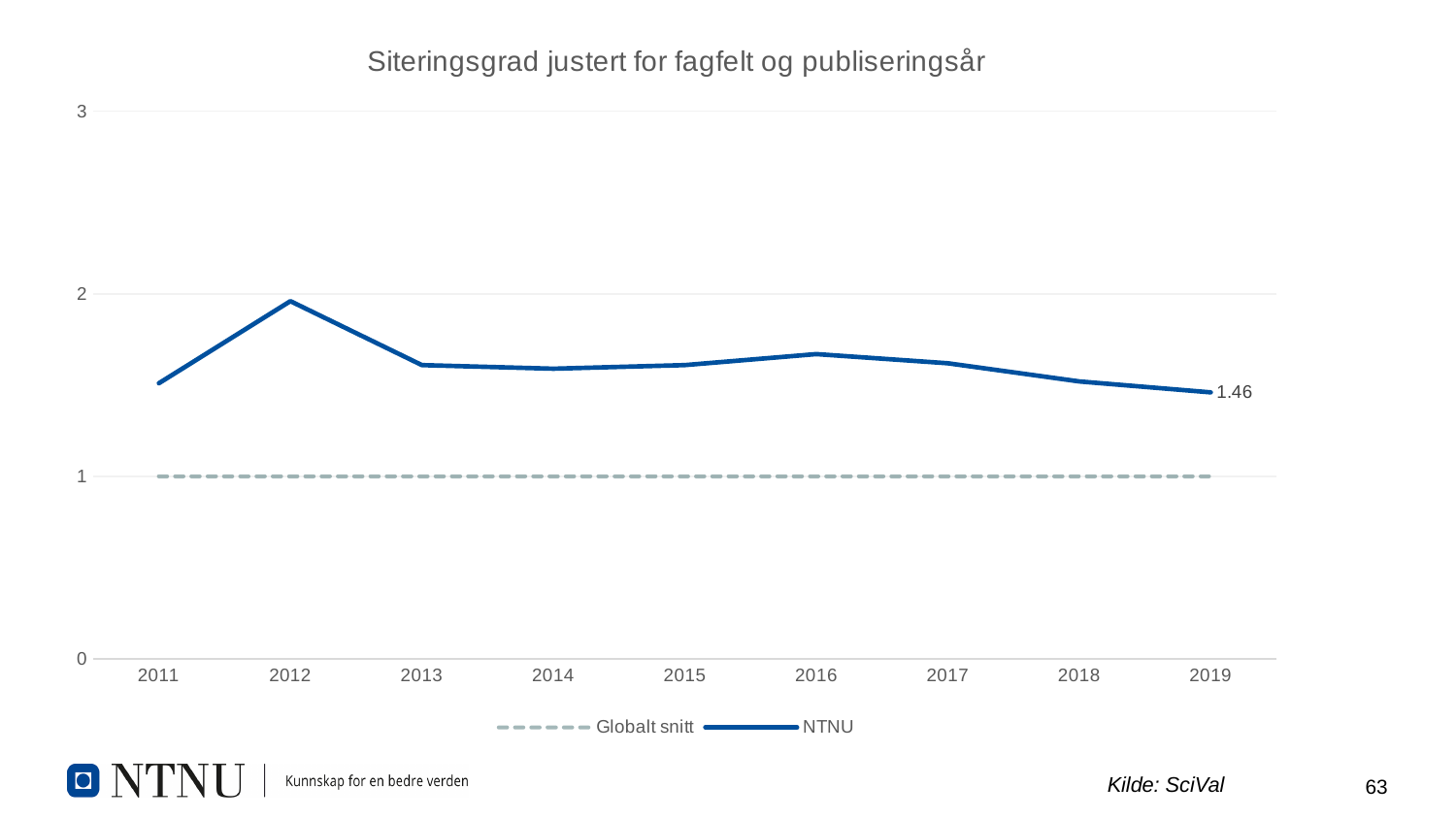
In which year is the NTNU value highest? 2012 What is the title of the chart? Siteringsgrad justert for fagfelt og publiseringsår Does the NTNU line rise or fall from 2016 to 2019? fall Which year has the larger NTNU value, 2012 or 2013? 2012 Is the NTNU value for 2016 greater or less than 2? less How many series does the legend list? 2 Which year has the larger NTNU value, 2016 or 2018? 2016 At what value does the Globalt snitt line sit across all years? 1 What is the NTNU value in 2019? 1.46 What kind of chart is shown on the slide? line chart Is the NTNU value for 2013 greater or less than 1? greater How many years are shown on the x axis? 9